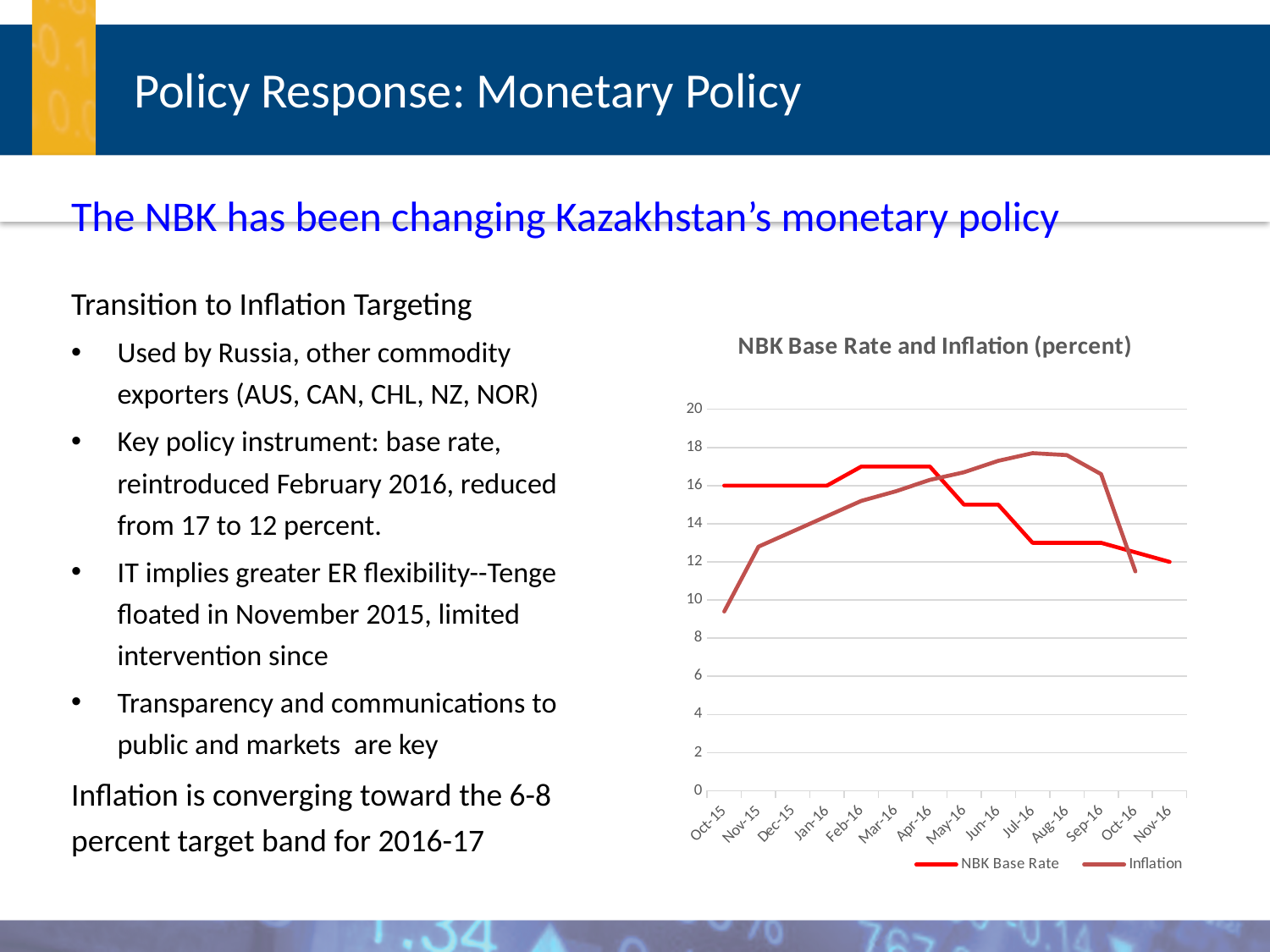
What is the NBK Base Rate in Oct-15? 16 What are the two series named in the chart legend? NBK Base Rate and Inflation In Jul-16, which is larger, the NBK Base Rate or Inflation? Inflation In which month is Inflation at its lowest? Oct-15 What kind of chart is shown on the slide? line chart What is the NBK Base Rate in Nov-16? 12 Is the value for NBK Base Rate in Feb-16 greater or less than 16? greater How many months are labelled along the x axis of the chart? 14 Is the value for Inflation in Oct-15 greater or less than 10? less How many series does the legend of the chart list? 2 Does Inflation rise or fall from Oct-15 to Jul-16? rise What is the title of the chart? NBK Base Rate and Inflation (percent)